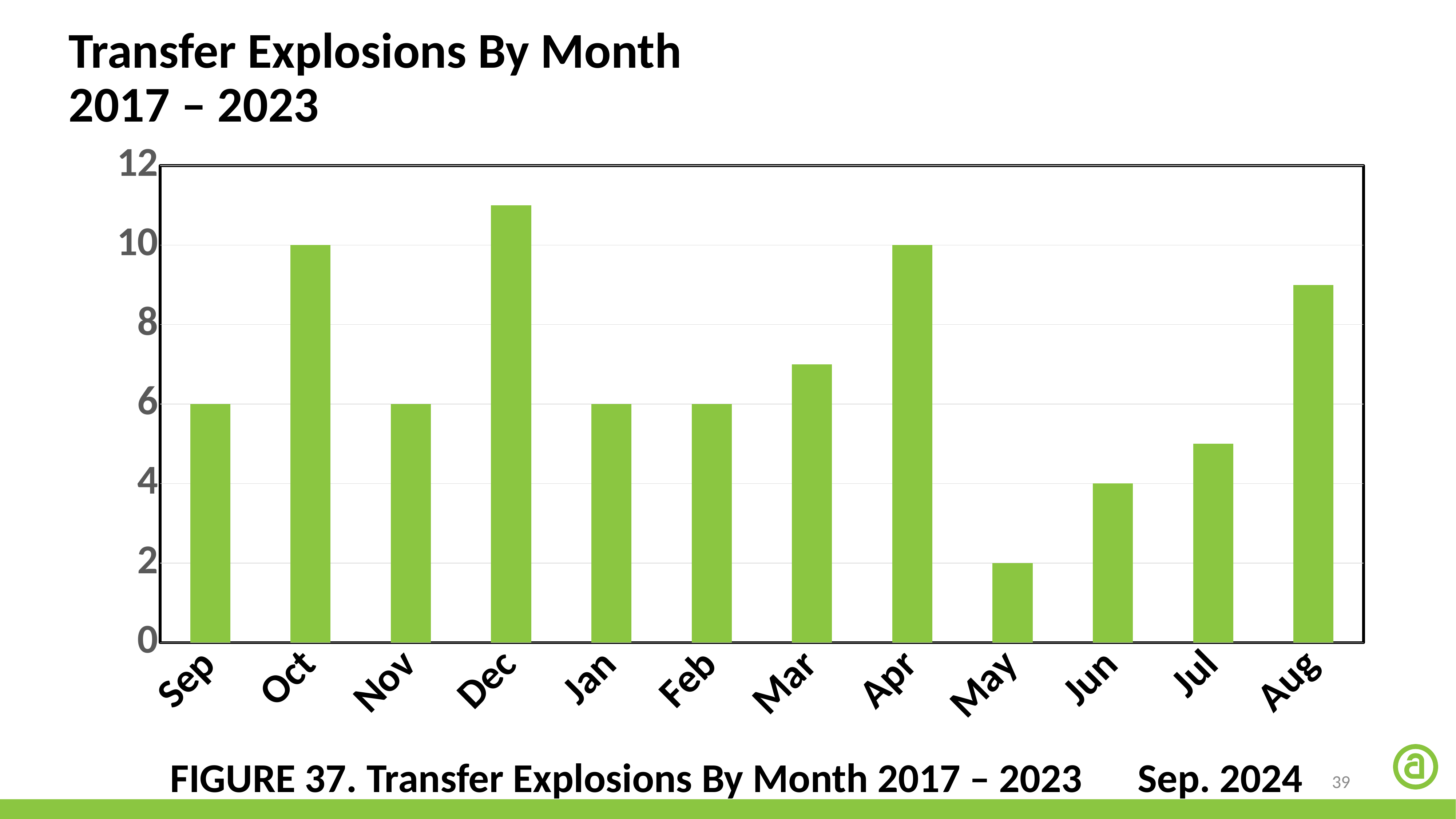
Is the value for Aug greater or less than 8? greater What is the difference between the values for Oct and Sep? 4 Which month has the lowest value? May Is the value for Dec greater or less than 10? greater What is the value for Sep? 6 What is the value for Oct? 10 Which month has the highest value? Dec What is the value for Jun? 4 Which is larger, the value for Mar or the value for Jul? Mar What is the value for May? 2 What kind of chart is shown on the slide? bar chart How many months are shown on the x axis of the chart? 12